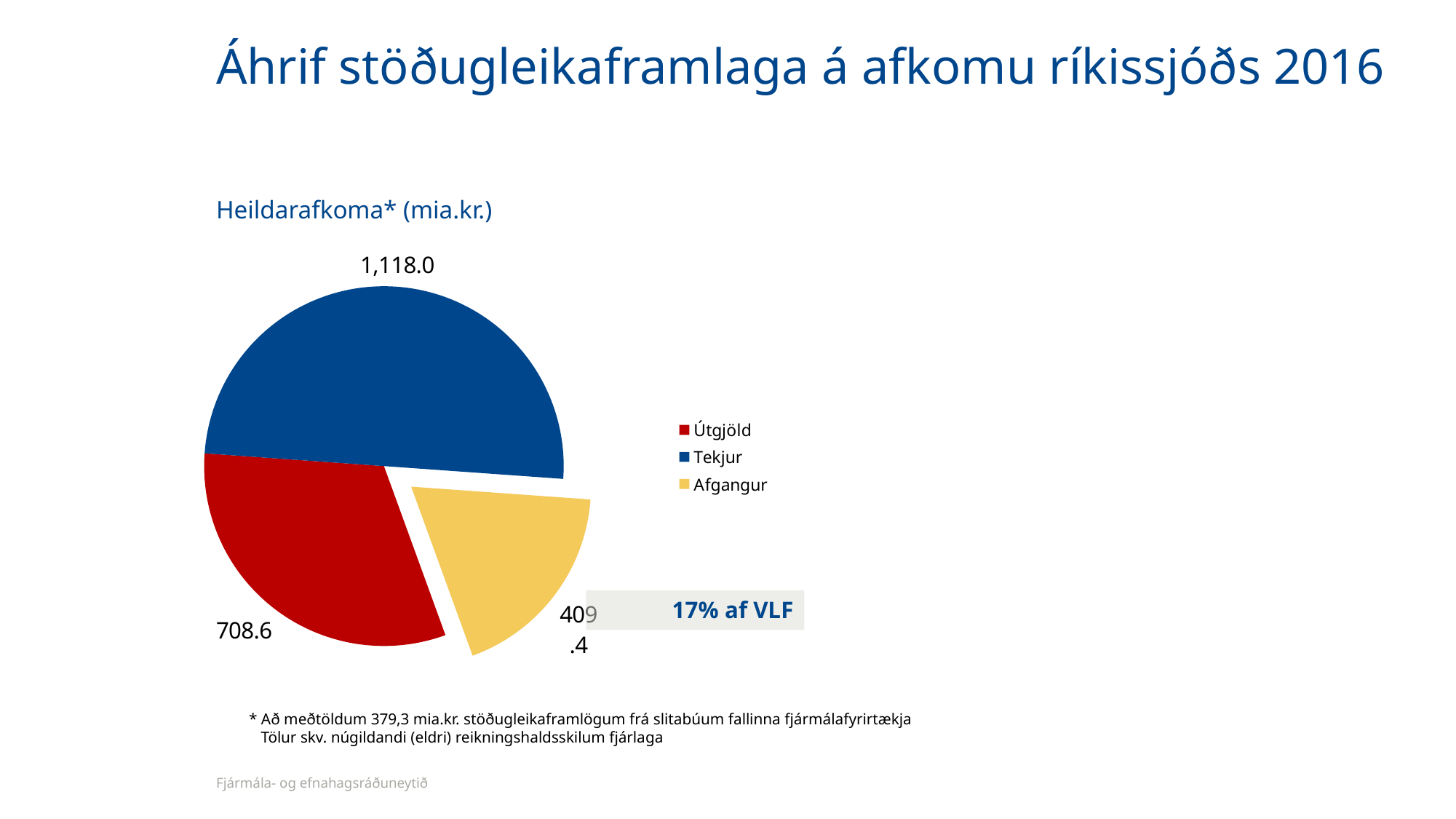
What is the title of the pie chart? Heildarafkoma* (mia.kr.) What is the difference between the values for Tekjur and Útgjöld? 409.4 How many entries does the legend list? 3 What colour is the Afgangur slice in the pie chart? yellow What is the value for Útgjöld in the pie chart? 708.6 Which is larger, Útgjöld or Afgangur? Útgjöld Which category has the smallest slice in the pie chart? Afgangur What kind of chart is shown on the slide? pie chart Which is larger, Tekjur or Útgjöld? Tekjur What is the value for Tekjur in the pie chart? 1,118.0 Which category has the largest slice in the pie chart? Tekjur How many slices does the pie chart have? 3